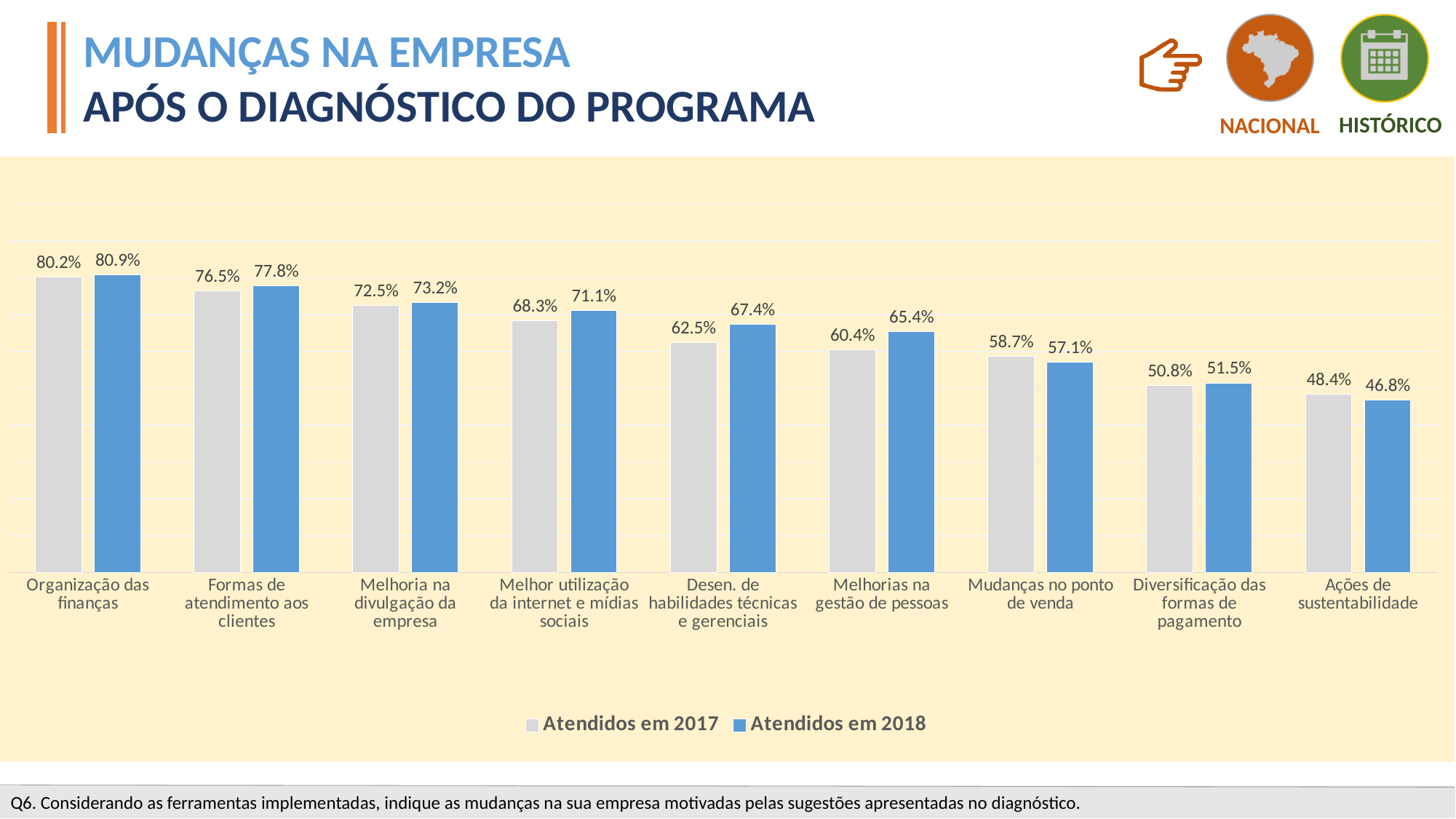
What kind of chart is shown on the slide? Bar chart What is the difference between the 2018 and 2017 values for "Desen. de habilidades técnicas e gerenciais"? 4.9 percentage points What is the value for "Atendidos em 2018" for "Organização das finanças"? 80.9% For "Ações de sustentabilidade", which is larger: the value for "Atendidos em 2017" or "Atendidos em 2018"? Atendidos em 2017 Which category has the lowest value for "Atendidos em 2018"? Ações de sustentabilidade What is the difference between the 2018 and 2017 values for "Melhorias na gestão de pessoas"? 5.0 percentage points Which category has the highest value for "Atendidos em 2017"? Organização das finanças How many categories are shown on the x axis of the chart? 9 Do the values for "Atendidos em 2017" rise or fall from left to right along the x axis? Fall What is the value for "Atendidos em 2018" for "Mudanças no ponto de venda"? 57.1% How many series does the legend list? 2 What is the value for "Atendidos em 2017" for "Melhor utilização da internet e mídias sociais"? 68.3%